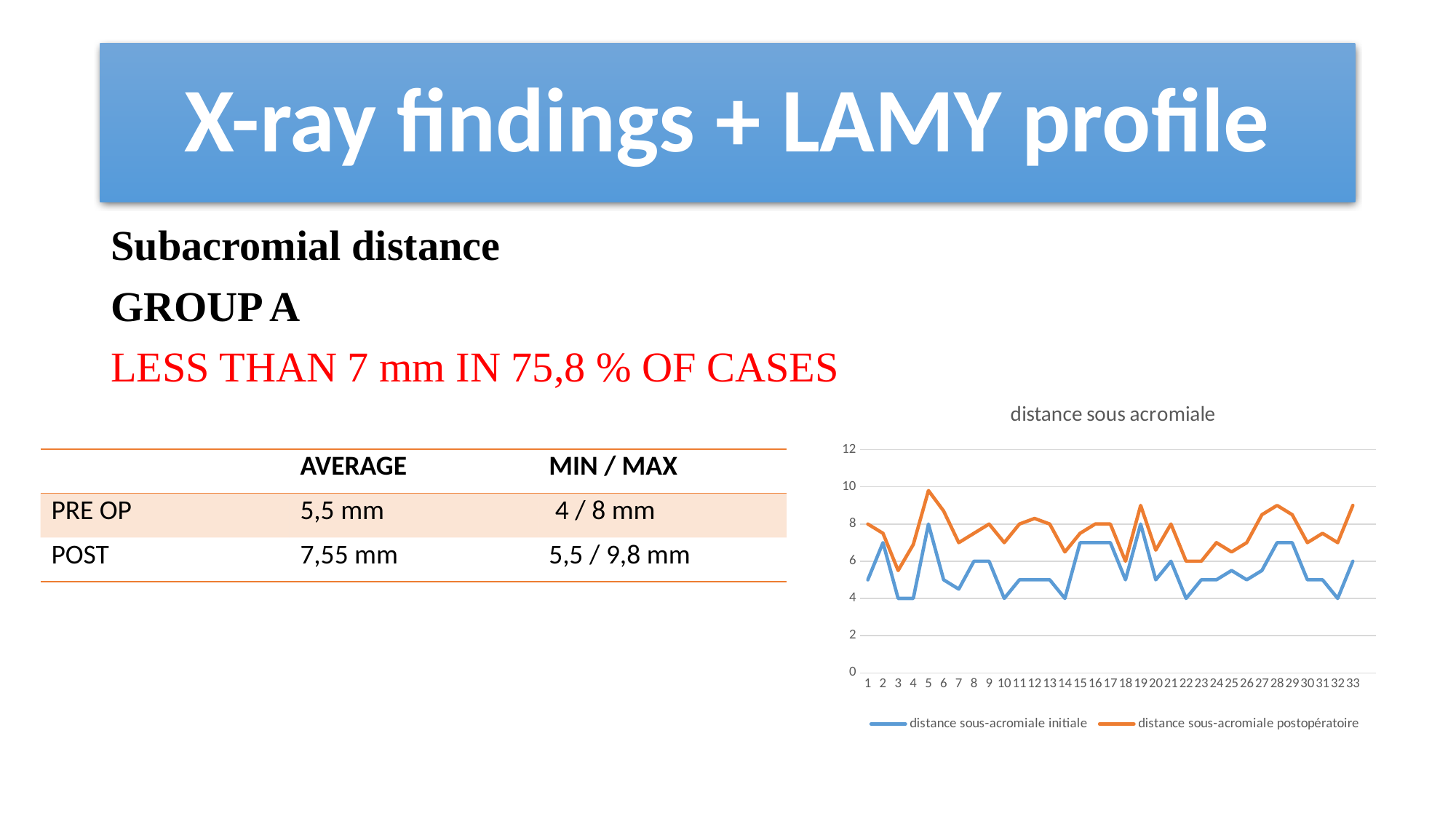
Is the value of 'distance sous-acromiale postopératoire' at point 5 greater or less than 8? greater What kind of chart is shown on the slide? line chart Is the value of 'distance sous-acromiale initiale' at point 5 greater or less than 6? greater How many series does the chart legend list? 2 At point 1, which series has the larger value: 'distance sous-acromiale initiale' or 'distance sous-acromiale postopératoire'? distance sous-acromiale postopératoire Is the value of 'distance sous-acromiale postopératoire' at point 33 greater or less than 8? greater What is the title of the chart? distance sous acromiale How many points are plotted along the x axis of the chart? 33 At point 5, which series has the larger value: 'distance sous-acromiale initiale' or 'distance sous-acromiale postopératoire'? distance sous-acromiale postopératoire Which series is drawn in orange in the chart? distance sous-acromiale postopératoire